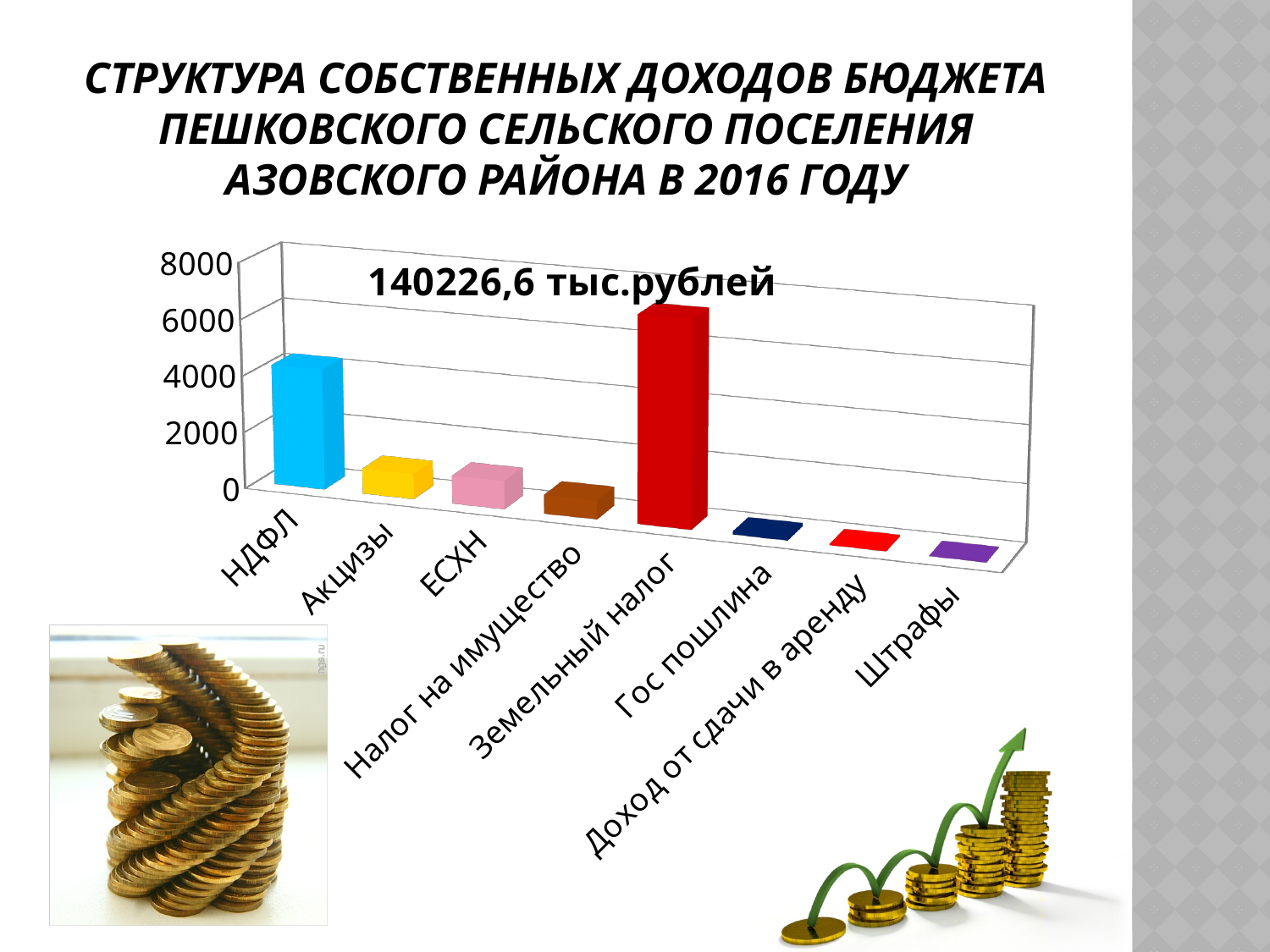
Is the value for Акцизы greater or less than 2000? less Which is larger, the value for НДФЛ or the value for Земельный налог? Земельный налог Which is larger, the value for НДФЛ or the value for Акцизы? НДФЛ Is the value for Земельный налог greater or less than 4000? greater Is the value for НДФЛ greater or less than 2000? greater What kind of chart is shown on the slide? bar chart How many categories are shown on the x axis of the chart? 8 Which category has the highest value in the chart? Земельный налог What colour is the bar for Земельный налог? red What text is printed inside the chart area above the bars? 140226,6 тыс.рублей